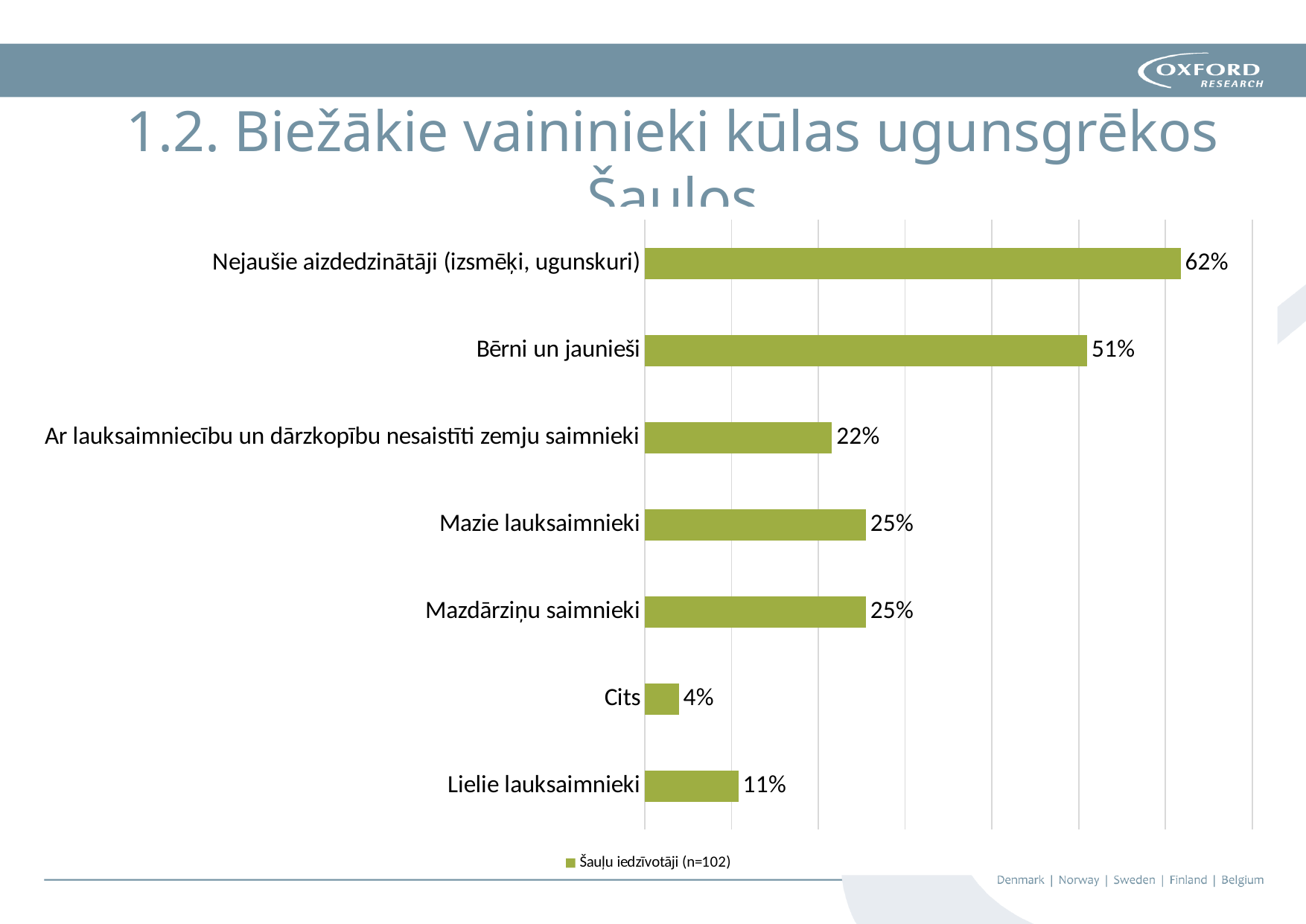
Which category has the highest value? Nejaušie aizdedzinātāji (izsmēķi, ugunskuri) What is the value for Nejaušie aizdedzinātāji (izsmēķi, ugunskuri)? 62% What is the value for Bērni un jaunieši? 51% What is the difference between the values for Nejaušie aizdedzinātāji (izsmēķi, ugunskuri) and Bērni un jaunieši? 11% What is the legend entry of the chart? Šauļu iedzīvotāji (n=102) Which category has the lowest value? Cits What kind of chart is shown on the slide? Bar chart What is the value for Lielie lauksaimnieki? 11% Which is larger: the value for Mazie lauksaimnieki or the value for Ar lauksaimniecību un dārzkopību nesaistīti zemju saimnieki? Mazie lauksaimnieki How many categories are shown in the chart? 7 How many series does the legend list? 1 What is the value for Cits? 4%